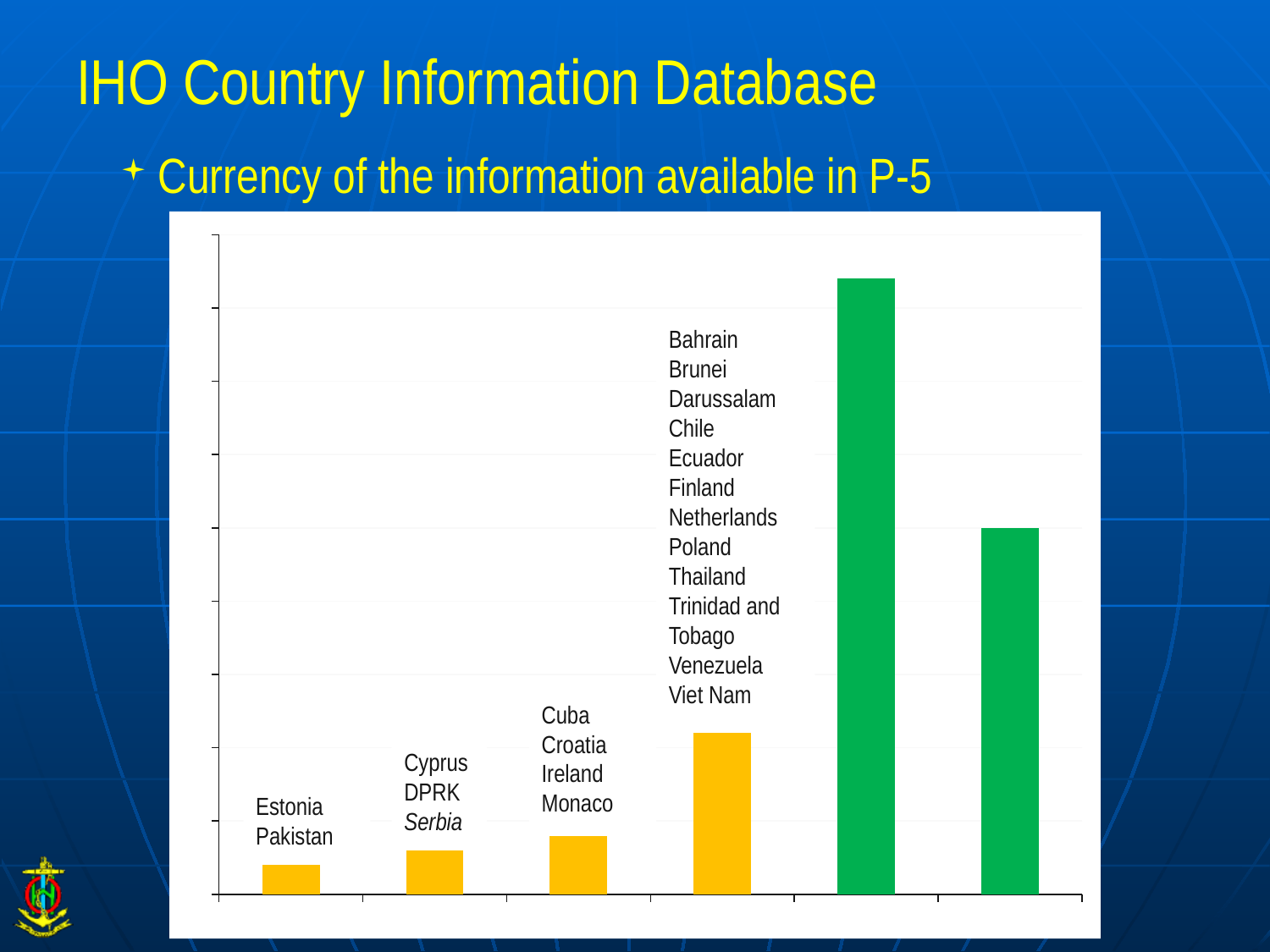
Which is taller: the bar labelled Bahrain through Viet Nam or the rightmost green bar? the rightmost green bar How many green bars are in the chart? 2 Do the yellow bars rise or fall from left to right? rise How many yellow bars are in the chart? 4 What kind of chart is shown on the slide? bar chart How many bars are plotted in the chart? 6 Which is taller: the bar labelled Cyprus/DPRK/Serbia or the bar labelled Cuba/Croatia/Ireland/Monaco? Cuba/Croatia/Ireland/Monaco Which two colours are used for the bars in the chart? yellow and green Which bar is the shortest in the chart? the first bar (labelled Estonia, Pakistan) Which bar is the tallest in the chart? the fifth bar (the first green bar) Which is taller: the first green bar or the second green bar? the first green bar Which countries are listed above the first (shortest) bar? Estonia, Pakistan